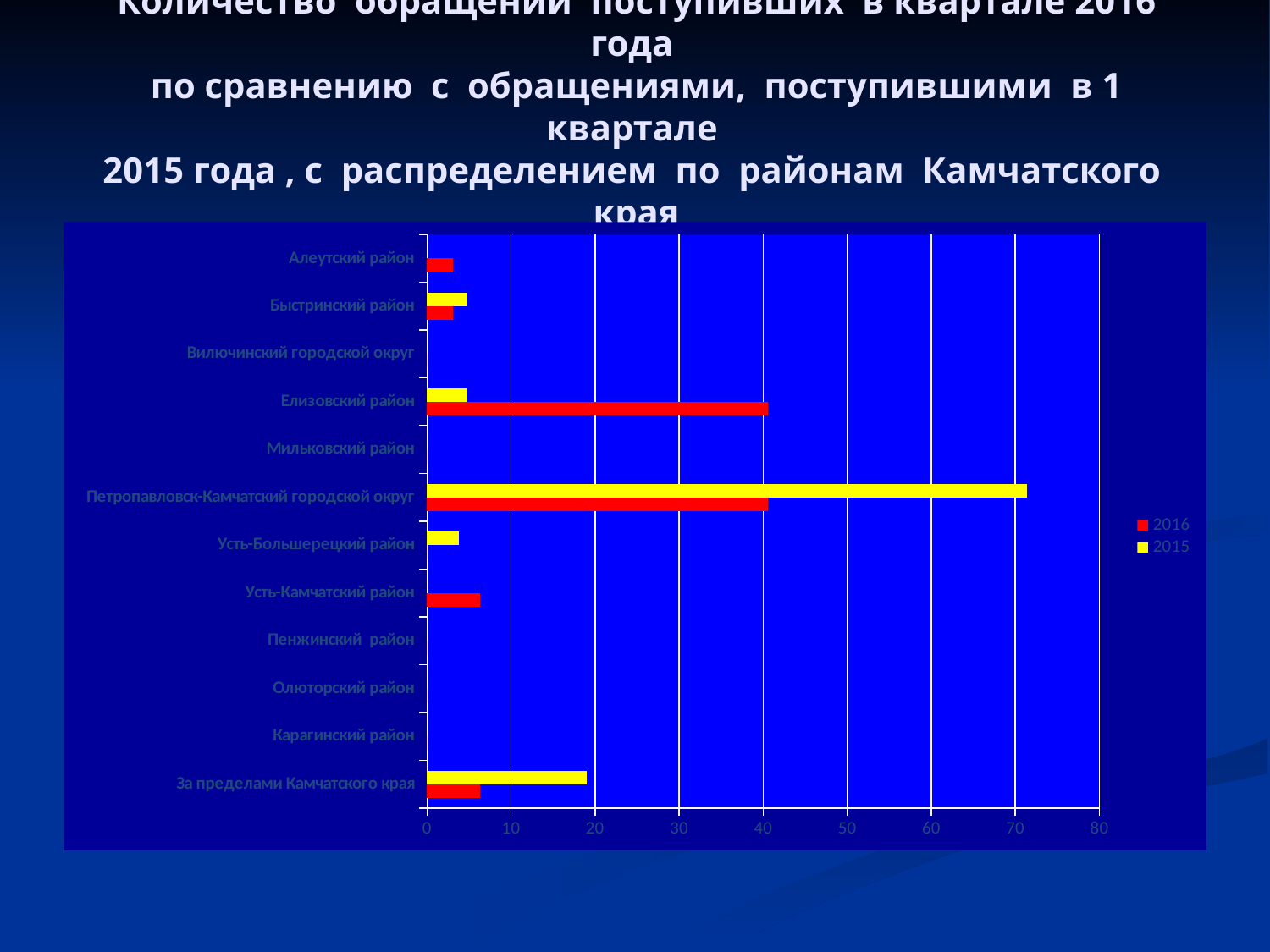
What kind of chart is shown on the slide? bar chart For Петропавловск-Камчатский городской округ, which series has the larger value, 2016 or 2015? 2015 Is the 2015 value for Петропавловск-Камчатский городской округ greater or less than 60? greater Which category has the highest value for the 2015 series? Петропавловск-Камчатский городской округ Which years are listed in the legend? 2016 and 2015 For Елизовский район, which series has the larger value, 2016 or 2015? 2016 How many series does the legend list? 2 Is the 2015 value for За пределами Камчатского края greater or less than 30? less Is the 2016 value for Елизовский район greater or less than 30? greater Which colour represents the 2016 series in the chart? red How many districts (categories) are listed on the vertical axis? 12